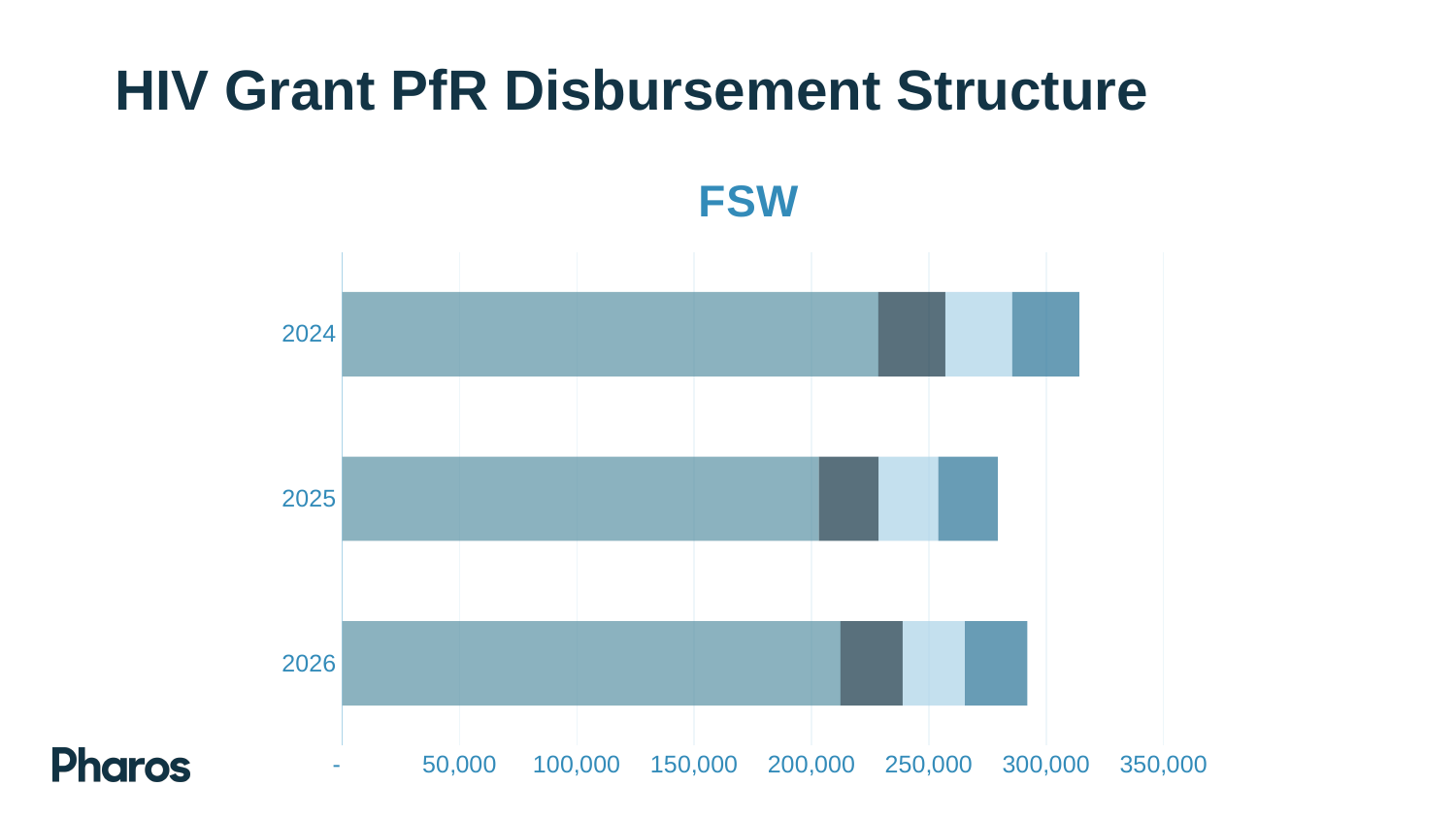
Is the total bar for 2024 longer or shorter than the total bar for 2025? Longer What is the highest value labelled on the horizontal axis? 350,000 Is the total value for 2025 greater or less than 250,000? greater What is the title of the chart? FSW Is the total value for 2025 greater or less than 300,000? less Is the total value for 2026 greater or less than 250,000? greater Which year has the shortest total bar? 2025 Which year has a longer total bar, 2026 or 2025? 2026 Which year has the longest total bar? 2024 How many categories (years) are shown on the chart? 3 What type of chart is shown on the slide? Stacked bar chart